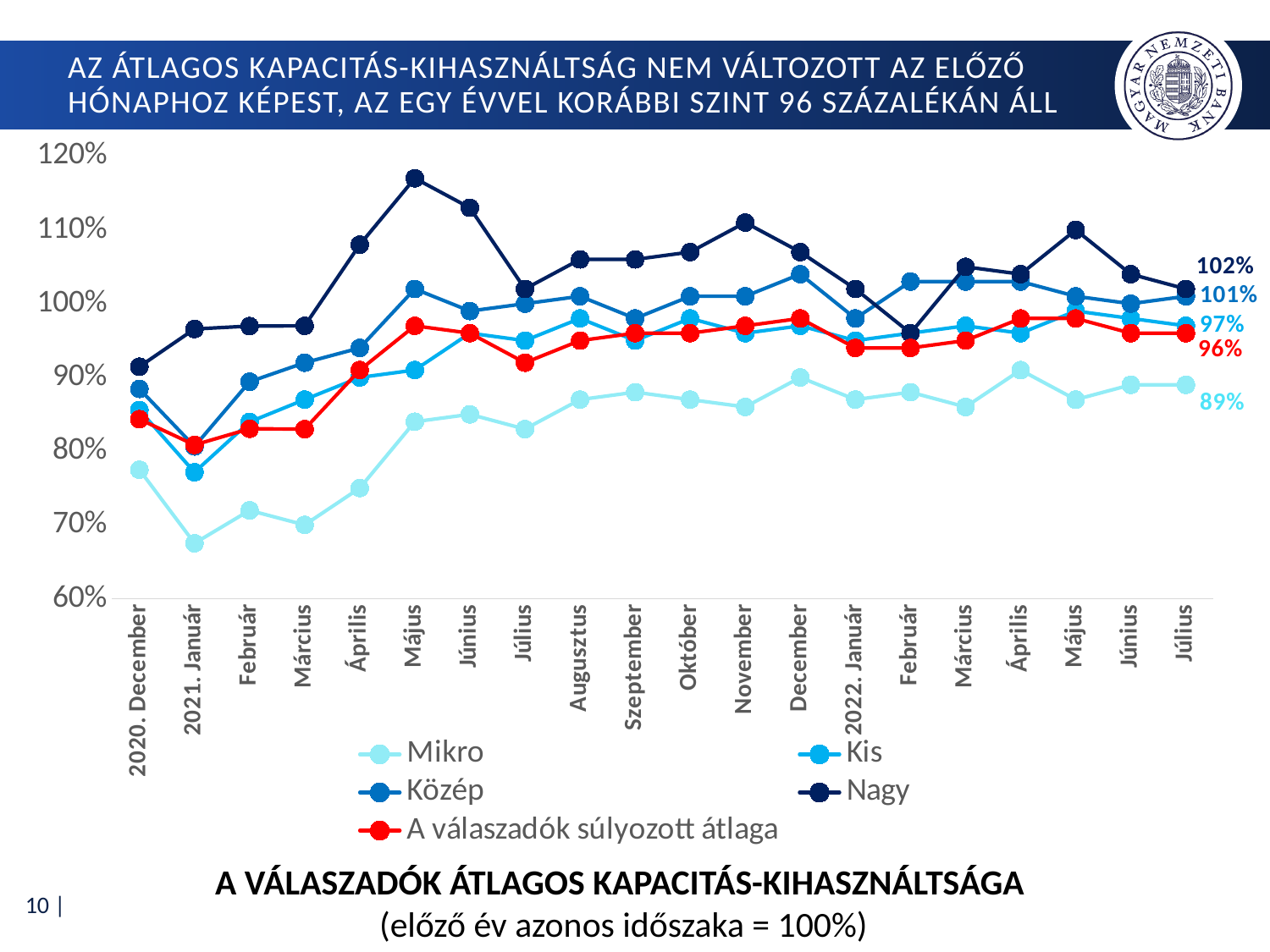
What is the value for Nagy in 2022 Július? 102% What is the value for Közép in 2022 Július? 101% What is the value for Mikro in 2022 Július? 89% What is the difference between the Nagy and Mikro values in 2022 Július? 13 percentage points Is the value for Nagy in 2021 Május greater or less than 110%? greater Which series has the highest value in 2022 Július? Nagy What is the value for A válaszadók súlyozott átlaga in 2022 Július? 96% Is the value for Mikro in 2021. Január greater or less than 70%? less In which month does the Nagy series reach its highest value? 2021. Május What kind of chart is shown on the slide? line chart How many months are plotted along the x axis? 20 How many series does the legend list? 5